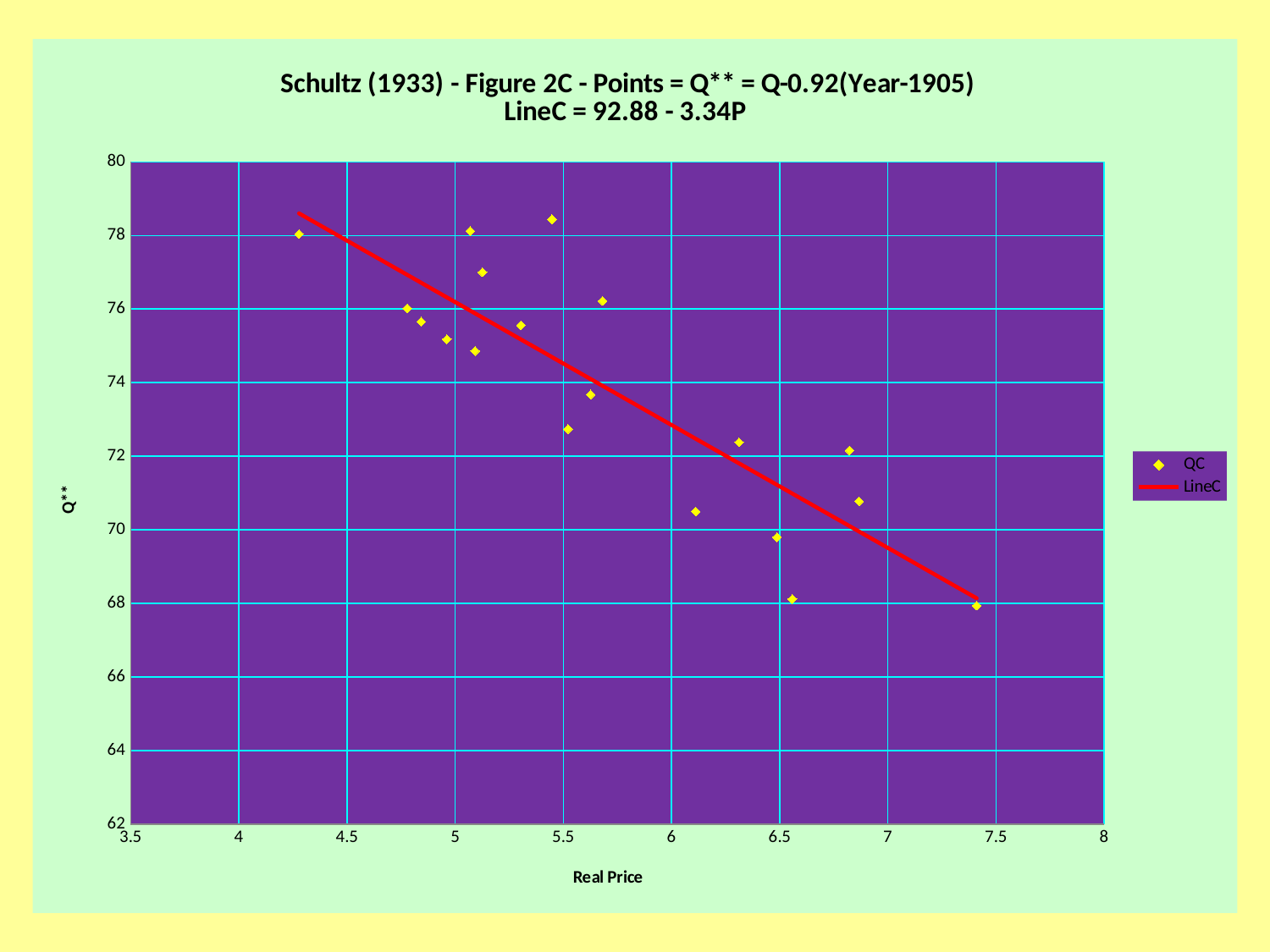
Do the QC points generally rise or fall as Real Price increases? fall What is the label of the x axis? Real Price Which has the larger Q** value: the QC point at a Real Price of about 5.7 or the QC point at a Real Price of about 6.1? the point at about 5.7 Is the Q** value of the QC point at a Real Price of about 4.3 greater or less than 76? greater What are the two entries in the chart legend? QC and LineC What is the maximum value shown on the y axis? 80 Is the LineC value at a Real Price of 4.5 greater or less than 76? greater What kind of chart is shown on the slide? scatter chart Is the Q** value of the QC point at a Real Price of about 7.4 greater or less than 70? less How many series does the legend list? 2 According to the chart title, what is the equation of LineC? LineC = 92.88 - 3.34P